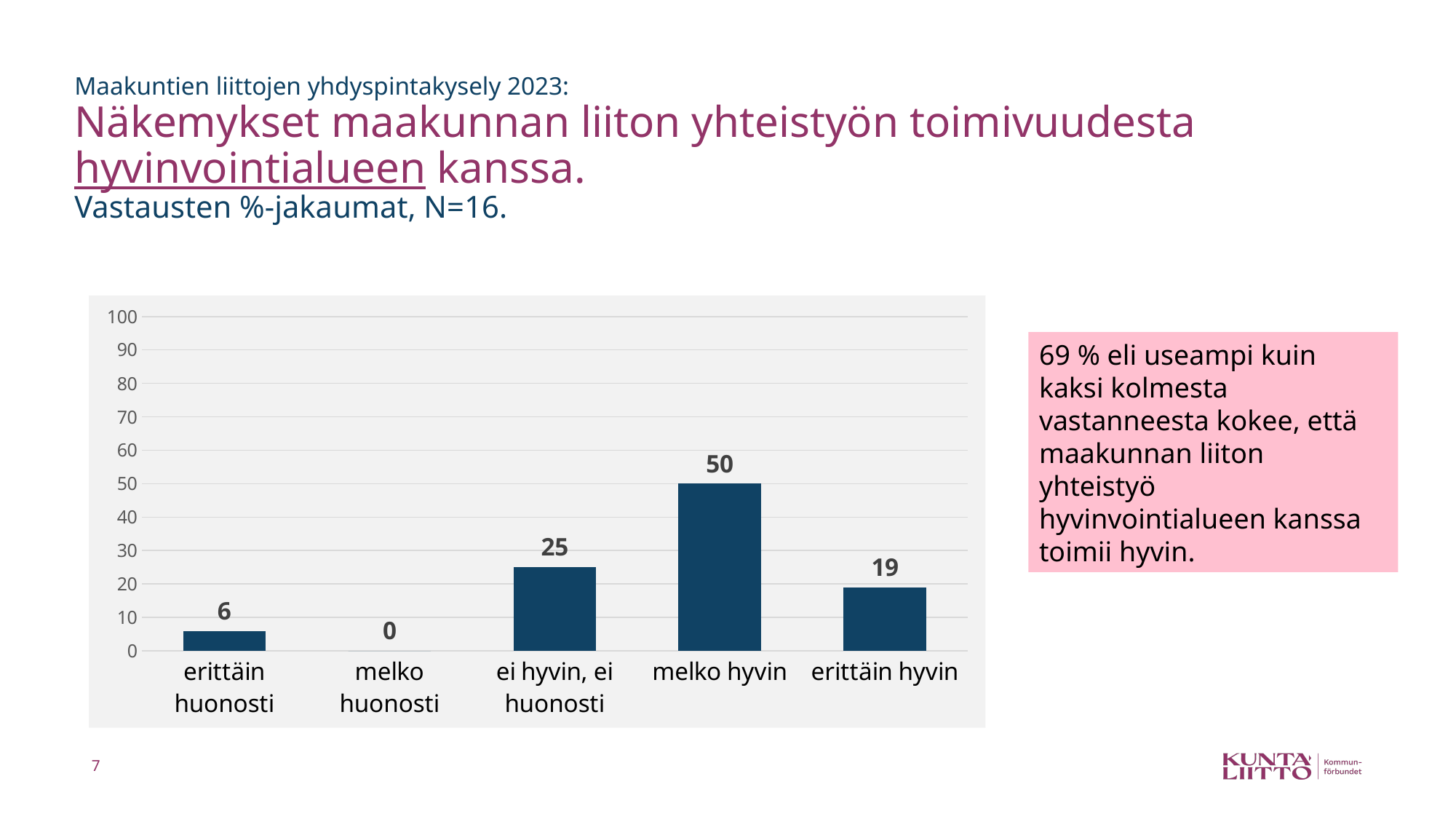
What kind of chart is shown on the slide? bar chart What is the value for "melko hyvin"? 50 Which category has the highest value? melko hyvin What is the value for "erittäin huonosti"? 6 What is the value for "erittäin hyvin"? 19 What is the maximum value shown on the y axis? 100 How many categories are shown on the x axis? 5 What is the difference between the values for "melko hyvin" and "ei hyvin, ei huonosti"? 25 Is the value for "melko hyvin" greater or less than 40? greater What is the value for "ei hyvin, ei huonosti"? 25 Which category has the lowest value? melko huonosti Which is larger, the value for "erittäin hyvin" or the value for "erittäin huonosti"? erittäin hyvin